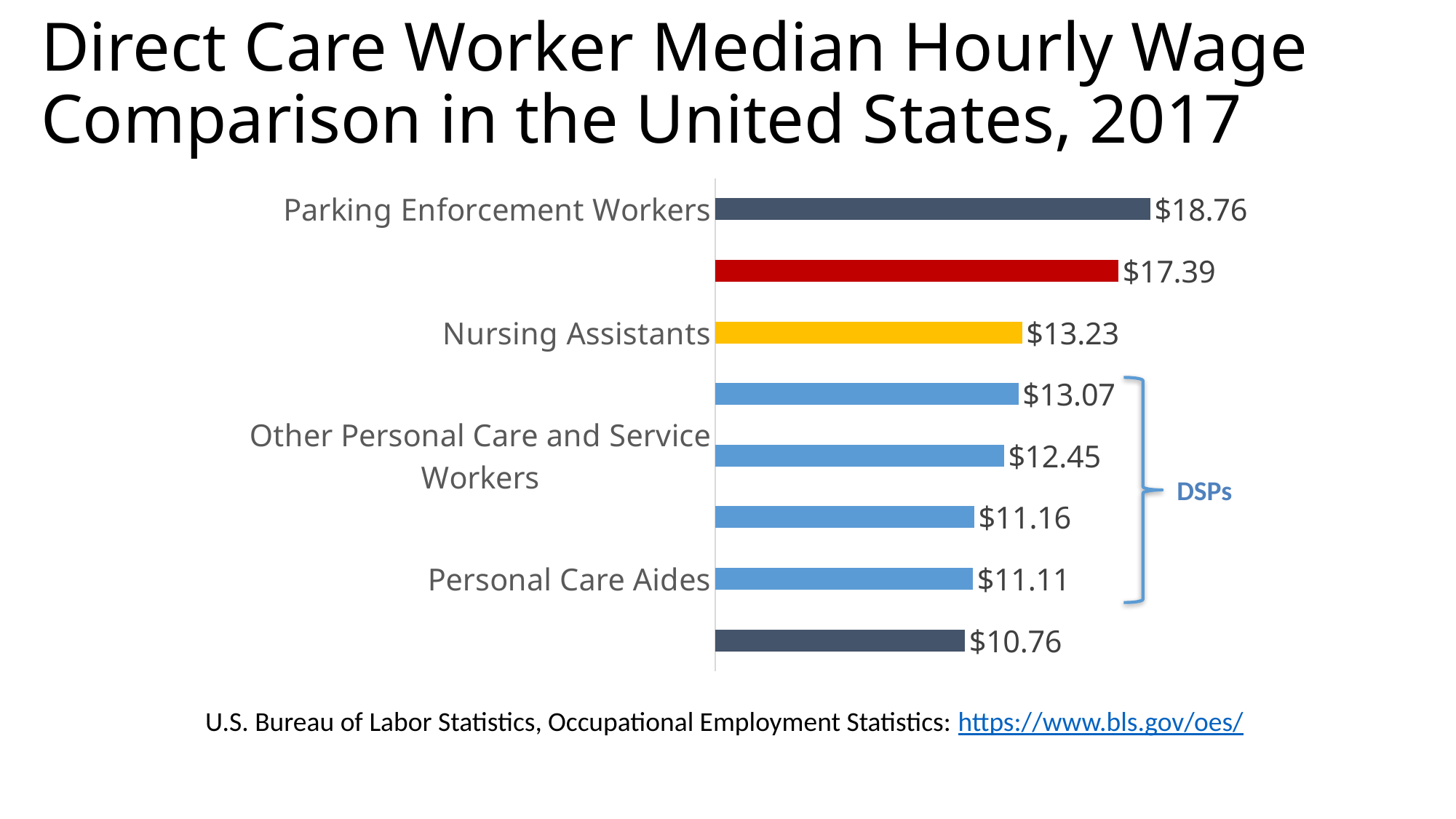
Which has a higher median hourly wage, Nursing Assistants or Personal Care Aides? Nursing Assistants How many bars are plotted on the chart? 8 What is the difference between the median hourly wage of Parking Enforcement Workers and Personal Care Aides? $7.65 How many bars are grouped under the DSPs bracket? 4 Which labeled category has the highest median hourly wage? Parking Enforcement Workers What is the median hourly wage shown for Personal Care Aides? $11.11 What is the lowest median hourly wage value shown on the chart? $10.76 What is the median hourly wage shown for Parking Enforcement Workers? $18.76 What is the median hourly wage shown for Nursing Assistants? $13.23 What kind of chart is shown on the slide? Bar chart What is the difference between the median hourly wage of Nursing Assistants and Other Personal Care and Service Workers? $0.78 What is the median hourly wage shown for Other Personal Care and Service Workers? $12.45